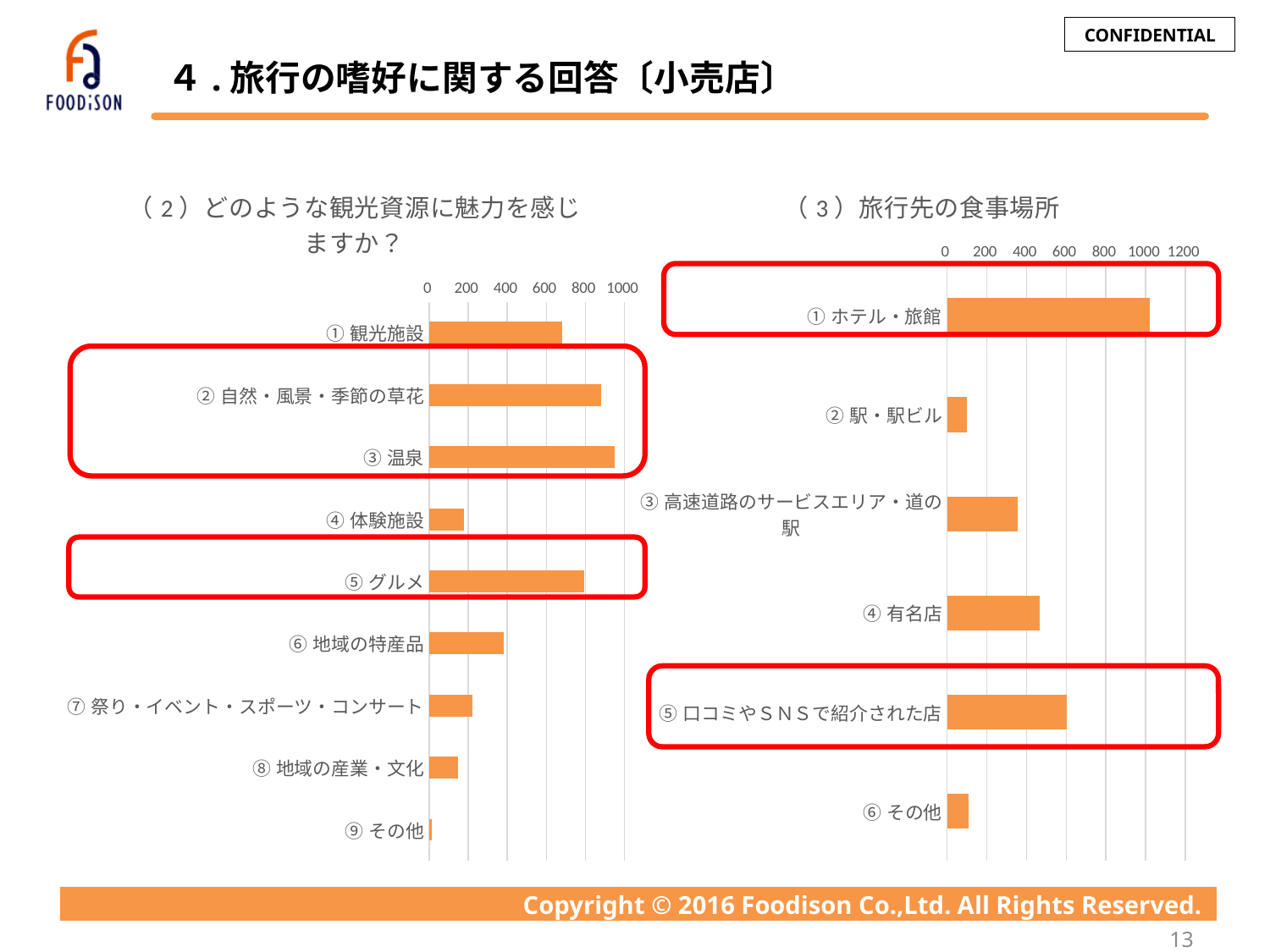
In the chart titled （３）旅行先の食事場所, which is larger: ④ 有名店 or ⑤ 口コミやＳＮＳで紹介された店? ⑤ 口コミやＳＮＳで紹介された店 In the chart titled （３）旅行先の食事場所, is the value for ② 駅・駅ビル greater or less than 200? less In the chart titled （２）どのような観光資源に魅力を感じますか？, which category has the lowest value? ⑨ その他 How many categories are shown in the chart titled （３）旅行先の食事場所? 6 In the chart titled （２）どのような観光資源に魅力を感じますか？, is the value for ⑤ グルメ greater or less than 600? greater In the chart titled （２）どのような観光資源に魅力を感じますか？, which category has the highest value? ③ 温泉 How many categories are shown in the chart titled （２）どのような観光資源に魅力を感じますか？? 9 In the chart titled （３）旅行先の食事場所, which category has the highest value? ① ホテル・旅館 In the chart titled （２）どのような観光資源に魅力を感じますか？, is the value for ④ 体験施設 greater or less than 400? less In the chart titled （２）どのような観光資源に魅力を感じますか？, which is larger: ⑥ 地域の特産品 or ⑦ 祭り・イベント・スポーツ・コンサート? ⑥ 地域の特産品 What kind of chart is the chart titled （２）どのような観光資源に魅力を感じますか？? bar chart